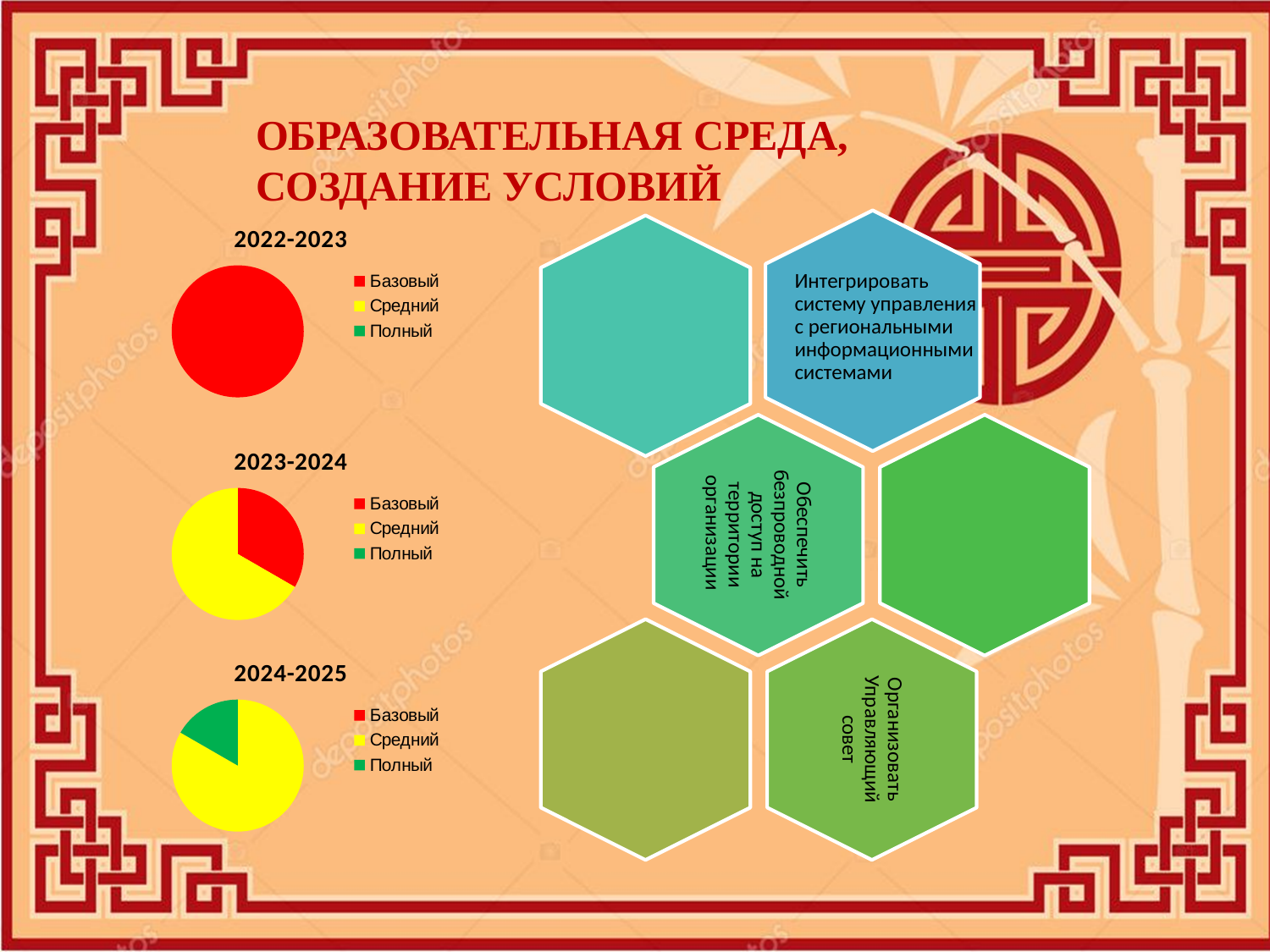
Which category is not visible in the 2024-2025 pie chart? Базовый In the 2024-2025 pie chart, which category has the largest slice? Средний How many pie charts are shown on the slide? 3 In the 2023-2024 pie chart, which slice is larger: Базовый or Средний? Средний In the 2022-2023 pie chart, which category takes up the whole pie? Базовый In the 2024-2025 pie chart, which category has the smallest visible slice? Полный In the 2024-2025 pie chart, which slice is larger: Полный or Средний? Средний What colour represents the category Полный in the legends of the pie charts? green In the 2023-2024 pie chart, which category has the largest slice? Средний What kind of chart is the 2022-2023 chart? pie chart How many entries does the legend of the 2023-2024 pie chart list? 3 What is the title of the pie chart at the bottom of the slide? 2024-2025